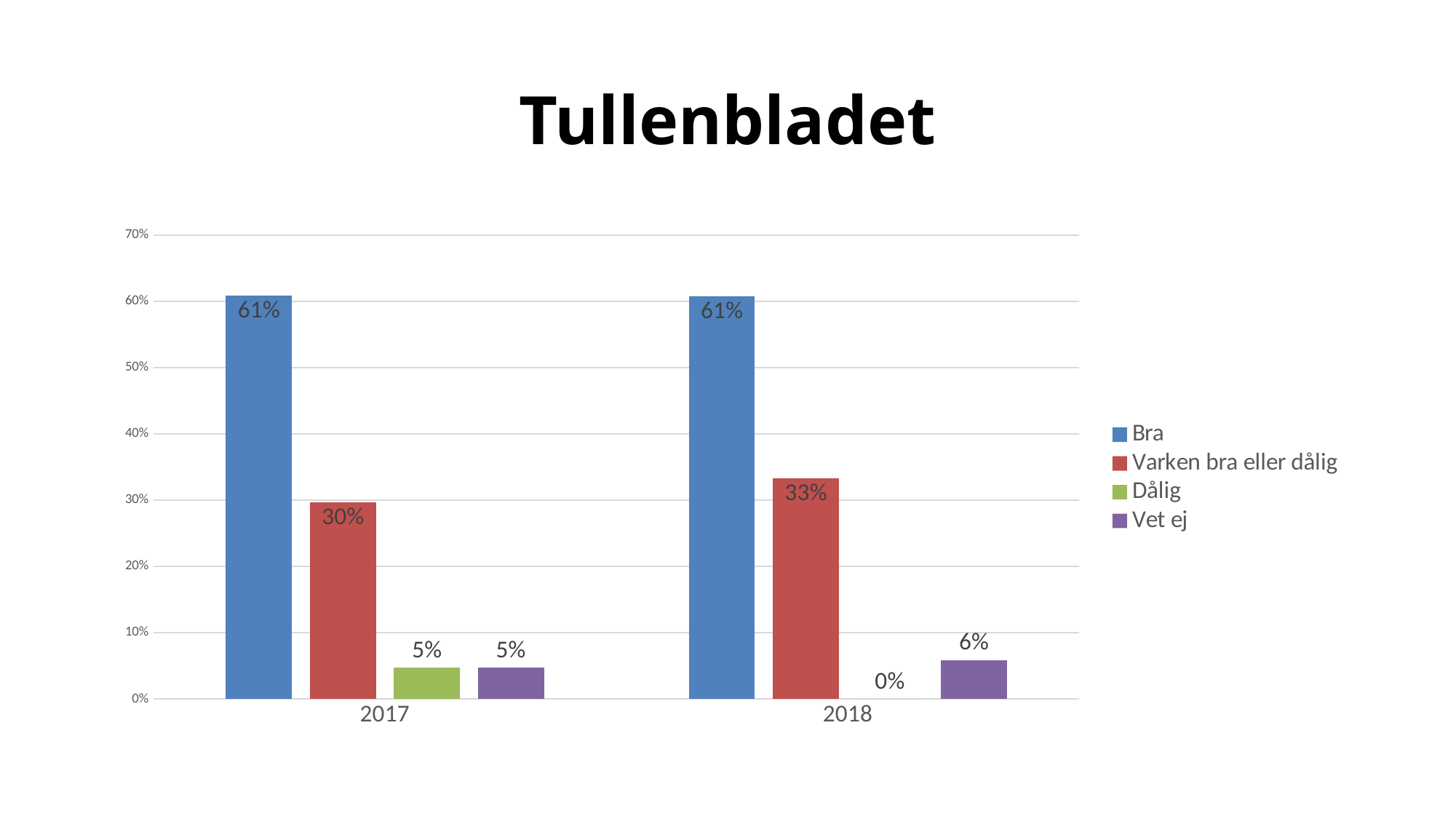
What is the title of the slide? Tullenbladet What is the value for Vet ej in 2017? 5% What kind of chart is shown on the slide? Bar chart What is the difference between Varken bra eller dålig in 2018 and in 2017? 3% How many categories are shown on the x axis? 2 How many series does the legend list? 4 What is the value for Varken bra eller dålig in 2018? 33% Which is larger, Vet ej in 2017 or Vet ej in 2018? Vet ej in 2018 What is the value for Dålig in 2018? 0% What is the value for Bra in 2017? 61% Which series has the highest value in 2018? Bra Which series has the lowest value in 2018? Dålig